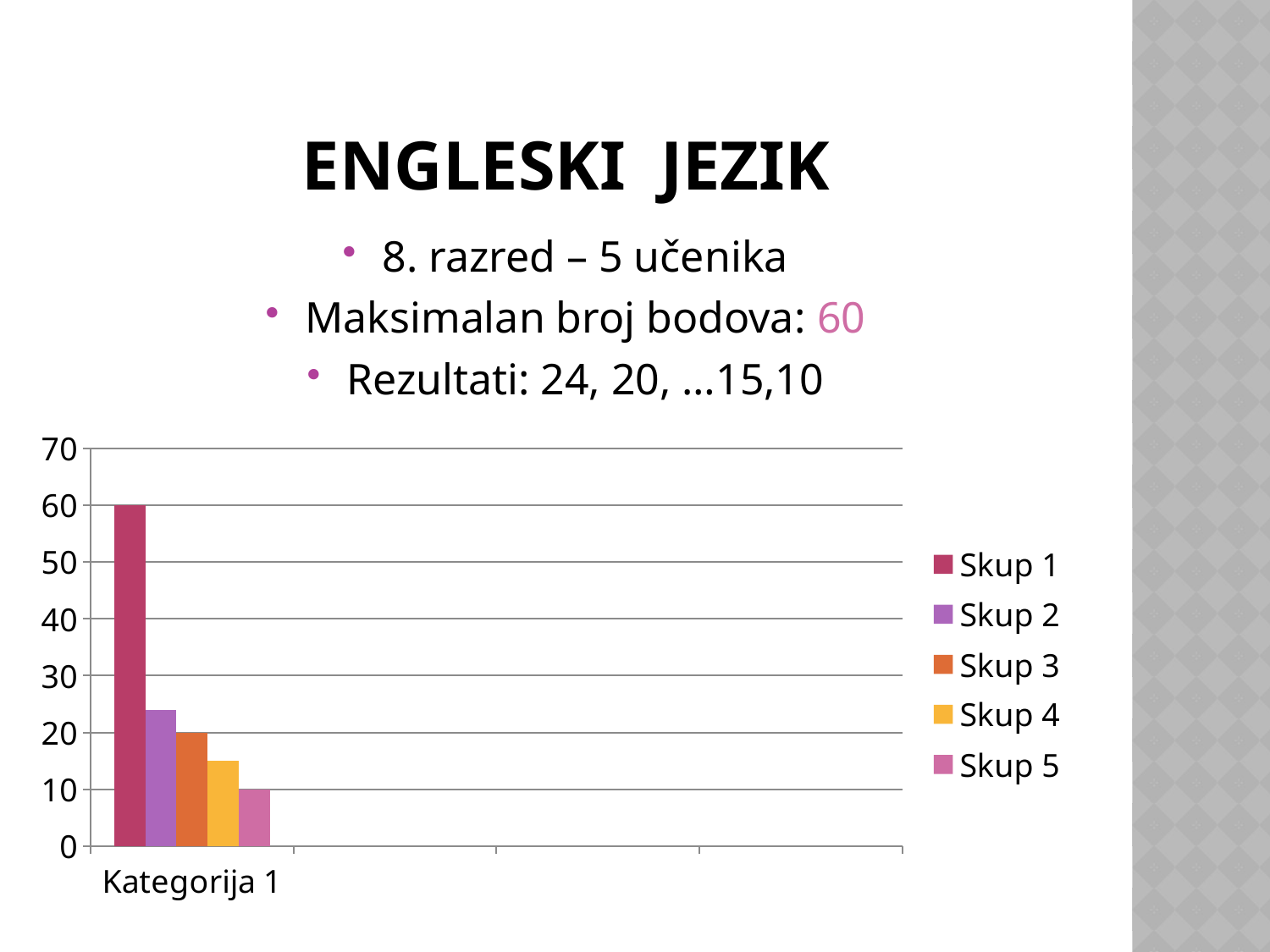
How many series does the chart legend list? 5 Which is larger, the value for Skup 3 or the value for Skup 5? Skup 3 Which series has the lowest value in the chart? Skup 5 Is the value for Skup 4 greater or less than 20? less How many categories are shown on the x axis of the chart? 1 What is the value of Skup 5 for Kategorija 1? 10 What is the value of Skup 3 for Kategorija 1? 20 Which series has the highest value in the chart? Skup 1 What is the difference between the values of Skup 1 and Skup 3? 40 What kind of chart is shown on the slide? bar chart What is the value of Skup 1 for Kategorija 1? 60 Is the value for Skup 2 greater or less than 20? greater